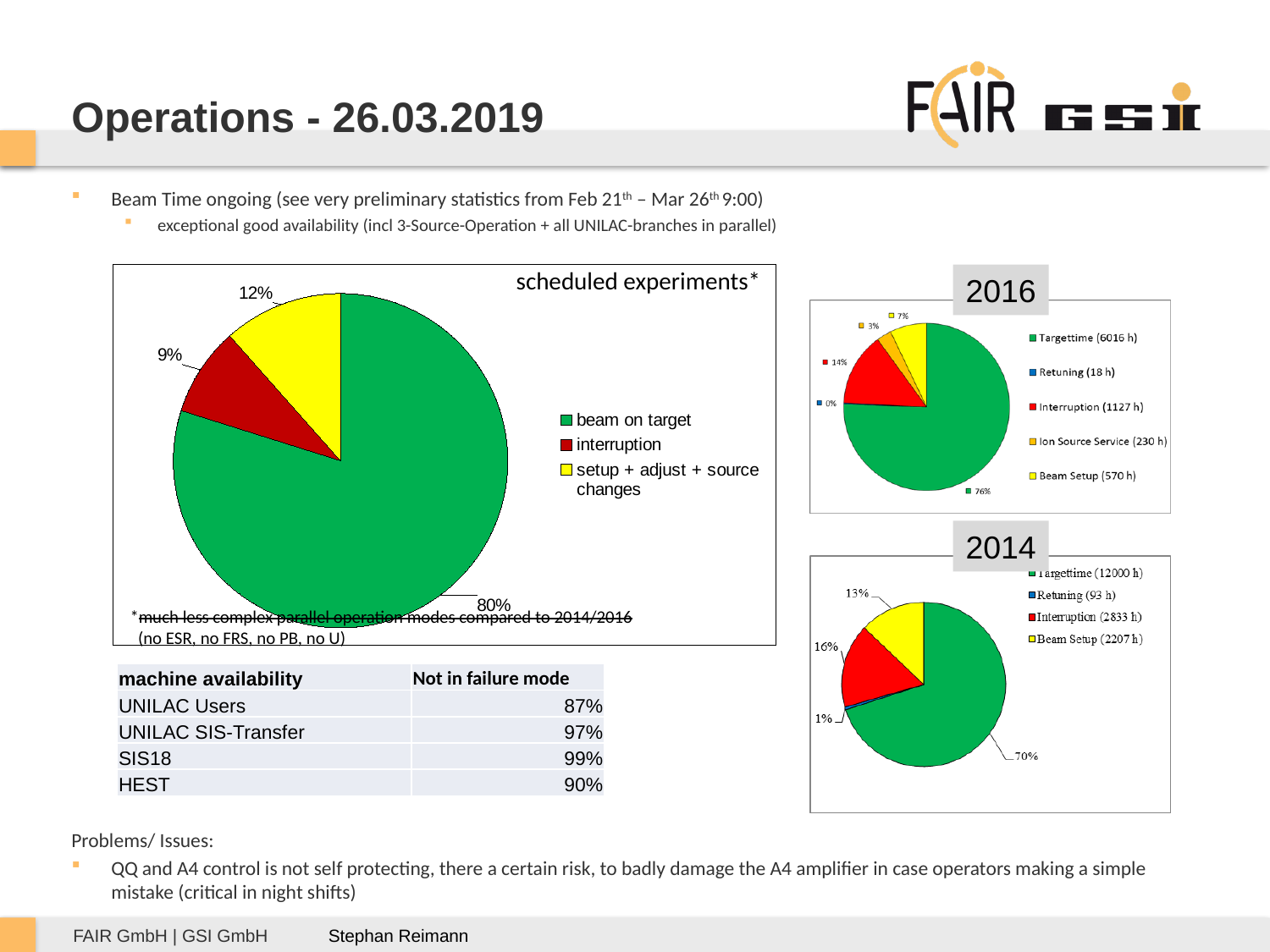
In the large 'scheduled experiments*' pie chart, which category has the largest slice? beam on target In the large 'scheduled experiments*' pie chart, what share is labelled for 'setup + adjust + source changes'? 12% In the large 'scheduled experiments*' pie chart, what share is labelled for 'interruption'? 9% In the 2014 pie chart, how many categories does the legend list? 4 In the 2016 pie chart, what percentage is labelled for Targettime? 76% In the 2014 pie chart, what percentage is labelled for Targettime? 70% In the 2016 pie chart, what percentage is labelled for Interruption? 14% In the large 'scheduled experiments*' pie chart, what share is labelled for 'beam on target'? 80% In the 2014 pie chart, what percentage is labelled for Interruption? 16% What type of chart is the large 'scheduled experiments*' chart? pie chart In the large 'scheduled experiments*' pie chart, how many categories does the legend list? 3 In the large 'scheduled experiments*' pie chart, which category has the smallest slice? interruption